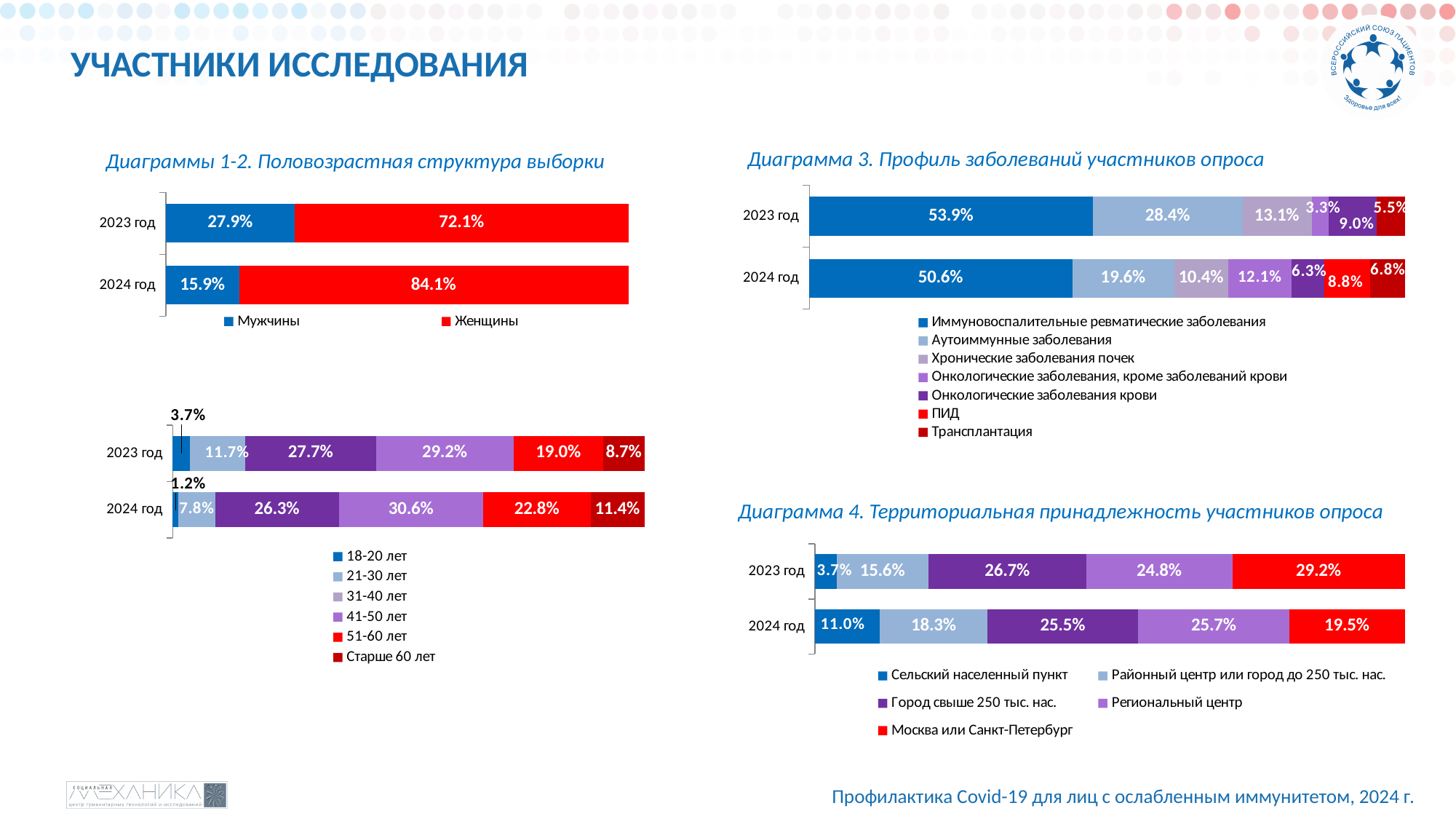
In the chart 'Диаграммы 1-2. Половозрастная структура выборки' (top-left), what is the value for Мужчины in 2023 год? 27.9% In the bottom-left age-structure chart, what is the value for 18-20 лет in 2023 год? 3.7% In the chart 'Диаграмма 4. Территориальная принадлежность участников опроса', which category has the lowest value in 2023 год? Сельский населенный пункт In the bottom-left age-structure chart, how many series does the legend list? 6 In the top-left gender chart, how many series does the legend list? 2 In the chart 'Диаграмма 4. Территориальная принадлежность участников опроса', what is the value for Москва или Санкт-Петербург in 2023 год? 29.2% In the chart 'Диаграмма 3. Профиль заболеваний участников опроса', what is the value for Иммуновоспалительные ревматические заболевания in 2024 год? 50.6% In the top-left gender chart, what is the value for Женщины in 2024 год? 84.1% In the top-left gender chart, what is the difference between the Женщины and Мужчины values for 2024 год? 68.2% What type of chart is 'Диаграмма 4. Территориальная принадлежность участников опроса'? Stacked bar chart In the chart 'Диаграмма 3. Профиль заболеваний участников опроса', which is larger for 2023 год: Аутоиммунные заболевания or Хронические заболевания почек? Аутоиммунные заболевания In the bottom-left age-structure chart, what is the value for Старше 60 лет in 2024 год? 11.4%